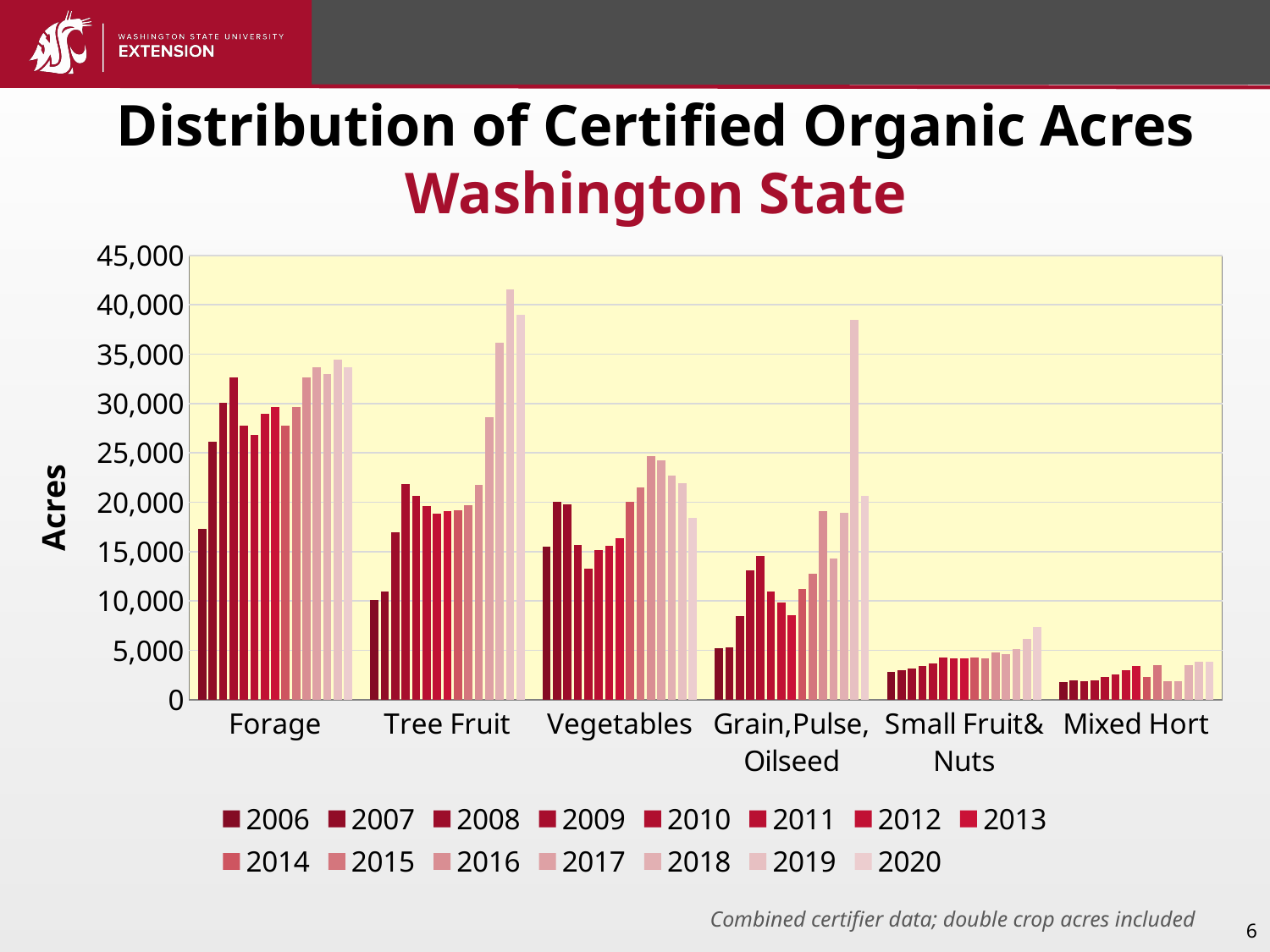
Which crop category contains the tallest single bar in the chart? Tree Fruit What type of chart is shown on the slide? Bar chart How many crop categories are shown on the x axis? 6 What is the label on the vertical axis of the chart? Acres Which crop category has the lowest bars overall? Mixed Hort Is the 2006 value for Forage greater or less than 15,000 acres? greater Is the 2006 value for Mixed Hort greater or less than 5,000 acres? less Do the Forage values generally rise or fall from 2006 to 2020? rise Is the tallest Grain, Pulse, Oilseed bar greater or less than 35,000 acres? greater Which is larger, the 2006 value for Forage or the 2006 value for Small Fruit & Nuts? Forage How many series (years) does the legend list? 15